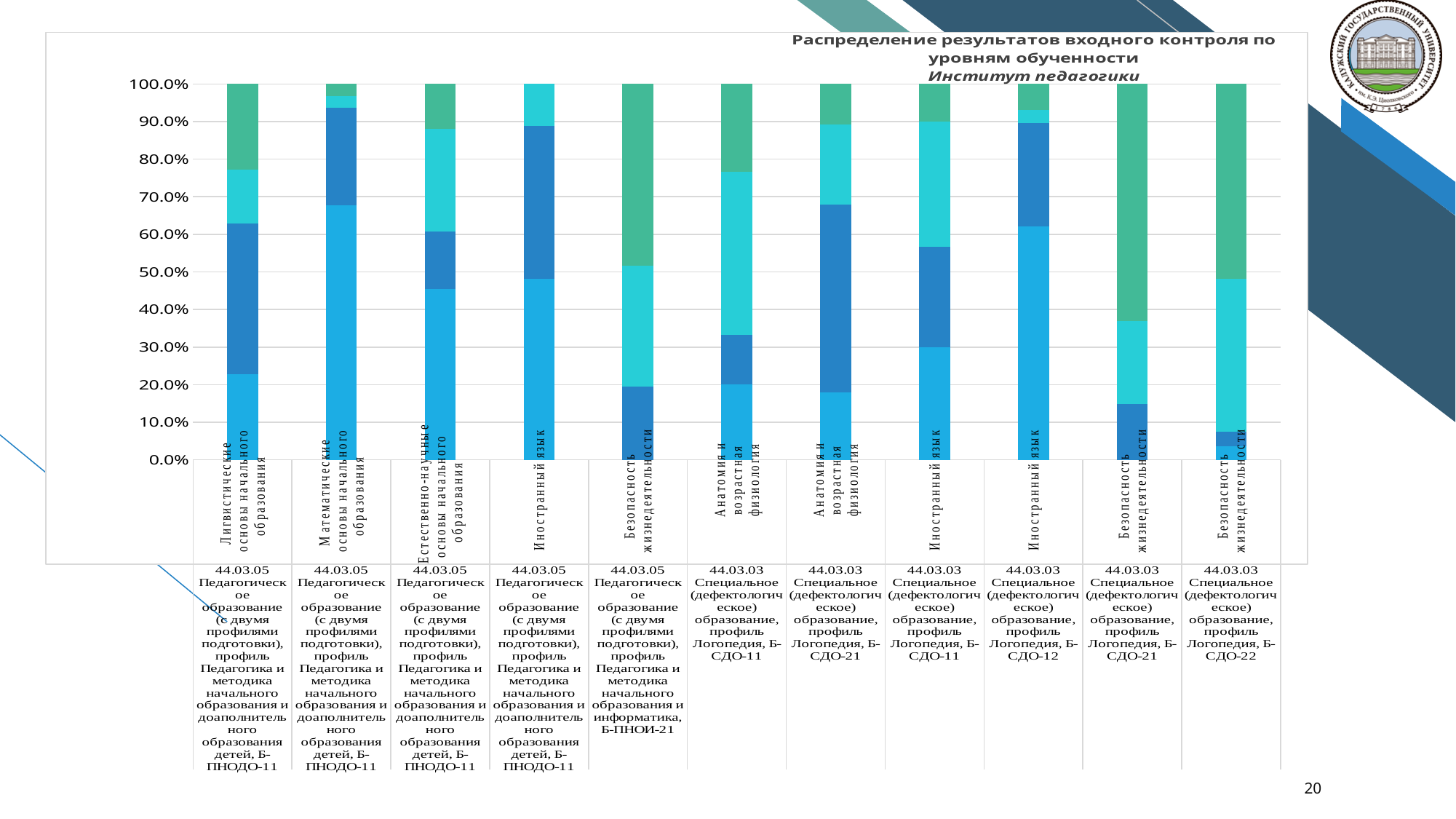
Which bar has the largest top (green) segment? Безопасность жизнедеятельности, Б-СДО-21 Is the bottom (light blue) segment of the bar for Математические основы начального образования, Б-ПНОДО-11 greater or less than 60%? greater Which bar has the larger bottom (light blue) segment: Математические основы начального образования, Б-ПНОДО-11 or Лингвистические основы начального образования, Б-ПНОДО-11? Математические основы начального образования, Б-ПНОДО-11 Is the bottom (light blue) segment of the bar for Иностранный язык, Б-ПНОДО-11 greater or less than 40%? greater Is the bottom (light blue) segment of the bar for Анатомия и возрастная физиология, Б-СДО-21 greater or less than 30%? less Which bar has the larger top (green) segment: Безопасность жизнедеятельности, Б-СДО-21 or Математические основы начального образования, Б-ПНОДО-11? Безопасность жизнедеятельности, Б-СДО-21 What kind of chart is shown on the slide? Stacked bar chart What is the title of the chart? Распределение результатов входного контроля по уровням обученности Институт педагогики How many bars (groups) are plotted in the chart? 11 What is the highest value shown on the vertical axis? 100.0%